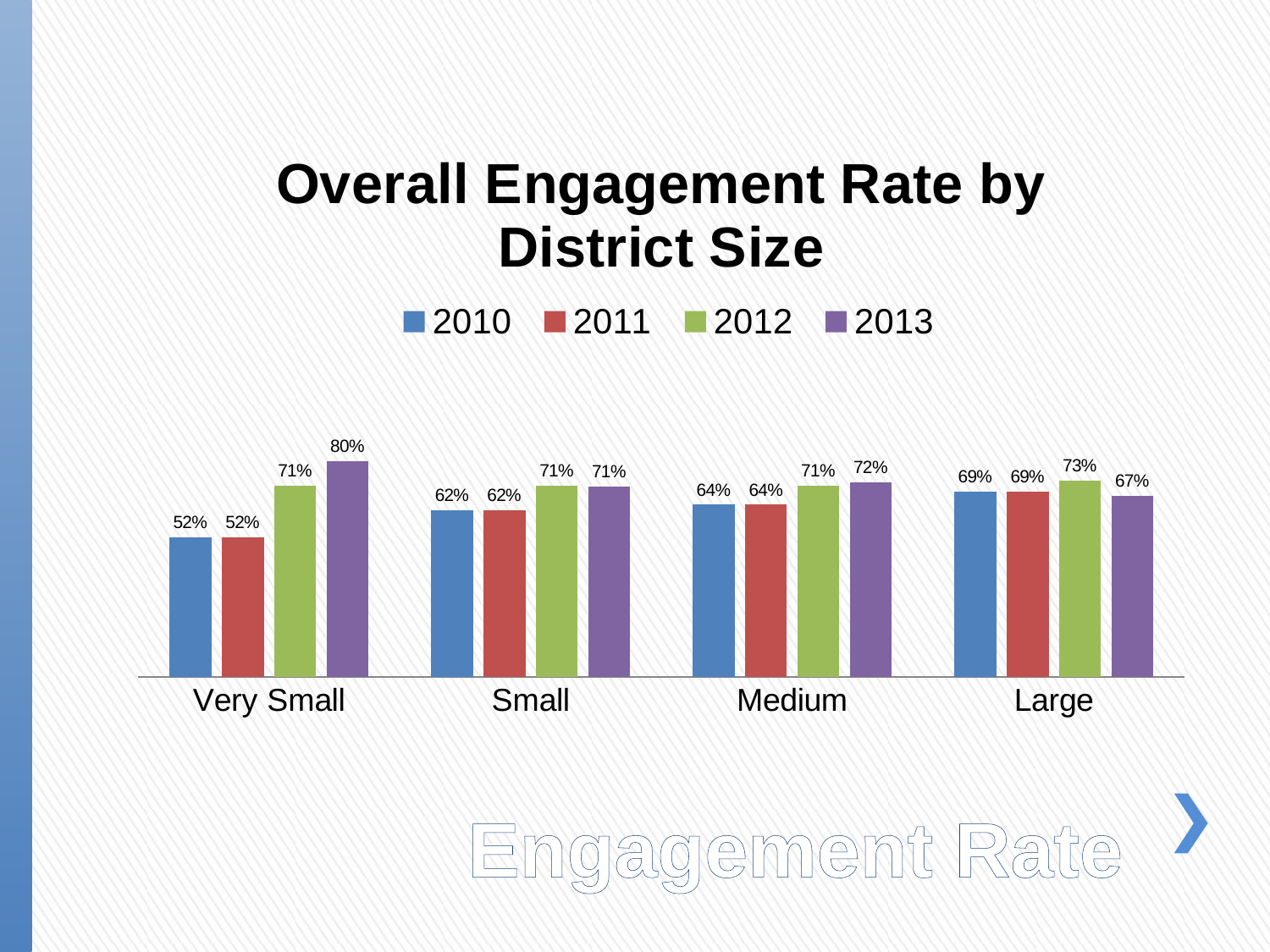
Which district size has the highest 2013 engagement rate? Very Small What is the 2012 engagement rate for Medium districts? 71% What is the title of the chart? Overall Engagement Rate by District Size What is the 2013 engagement rate for Very Small districts? 80% How many series does the legend list? 4 Which is larger: the 2013 rate for Medium districts or the 2013 rate for Large districts? Medium How many district size categories are shown on the x axis? 4 Which district size has the lowest 2010 engagement rate? Very Small Do the 2010 engagement rates rise or fall from Very Small to Large districts? Rise What is the 2010 engagement rate for Large districts? 69% What kind of chart is shown on the slide? Bar chart What is the difference between the 2013 and 2010 engagement rates for Very Small districts? 28%